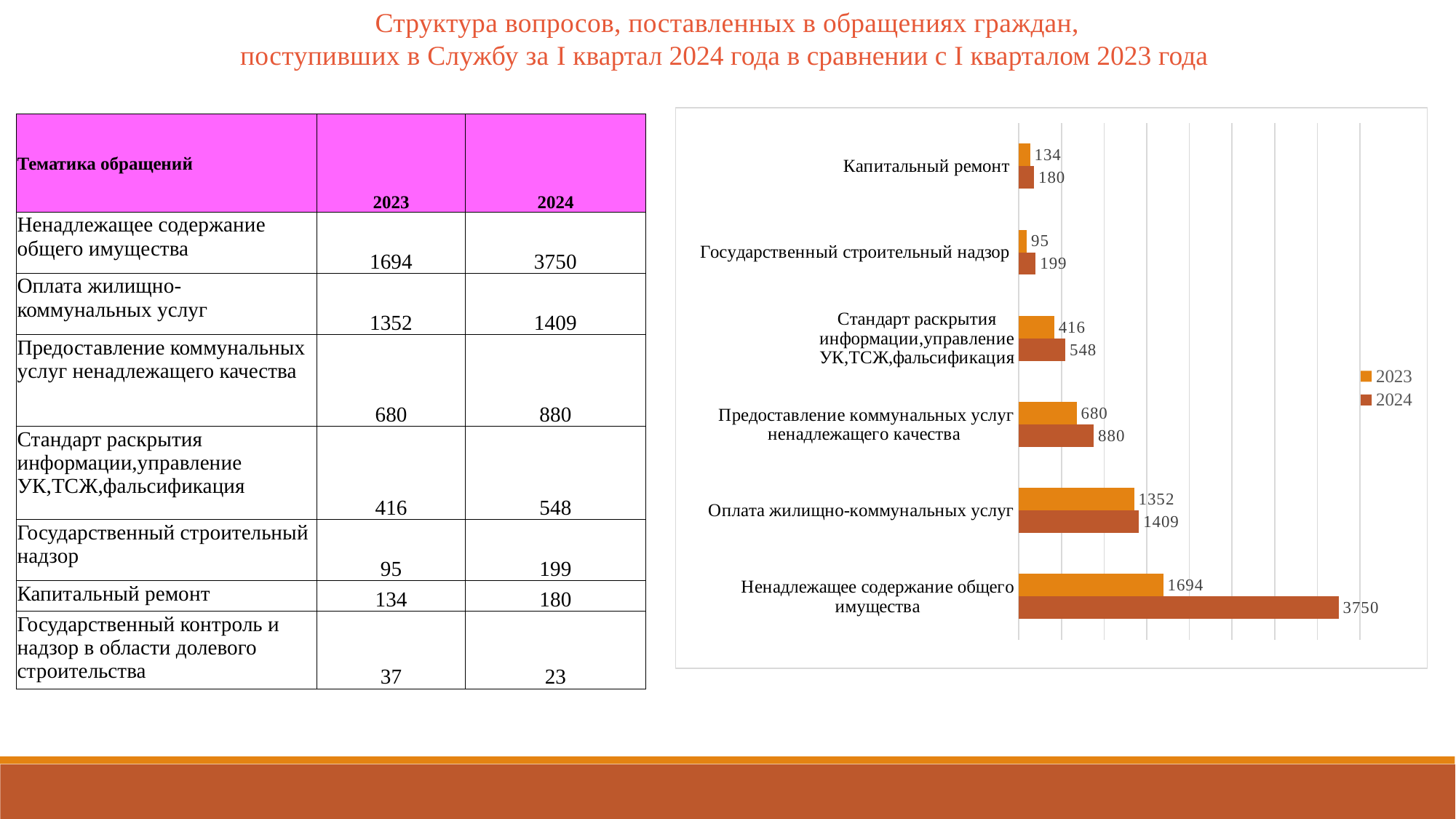
How many series does the chart legend list? 2 Which legend entry is shown in the darker brown colour in the chart? 2024 Which category has the lowest 2023 value in the chart? Государственный строительный надзор What is the 2024 value for Капитальный ремонт in the chart? 180 In the chart, which is larger for Оплата жилищно-коммунальных услуг: the 2023 value or the 2024 value? 2024 What is the 2023 value for Государственный строительный надзор in the chart? 95 What is the difference between the 2024 and 2023 values for Предоставление коммунальных услуг ненадлежащего качества in the chart? 200 What is the 2023 value for Стандарт раскрытия информации,управление УК,ТСЖ,фальсификация in the chart? 416 How many categories are plotted in the chart? 6 Which category has the highest 2024 value in the chart? Ненадлежащее содержание общего имущества What is the 2024 value for Ненадлежащее содержание общего имущества in the chart? 3750 What kind of chart is shown on the slide? bar chart